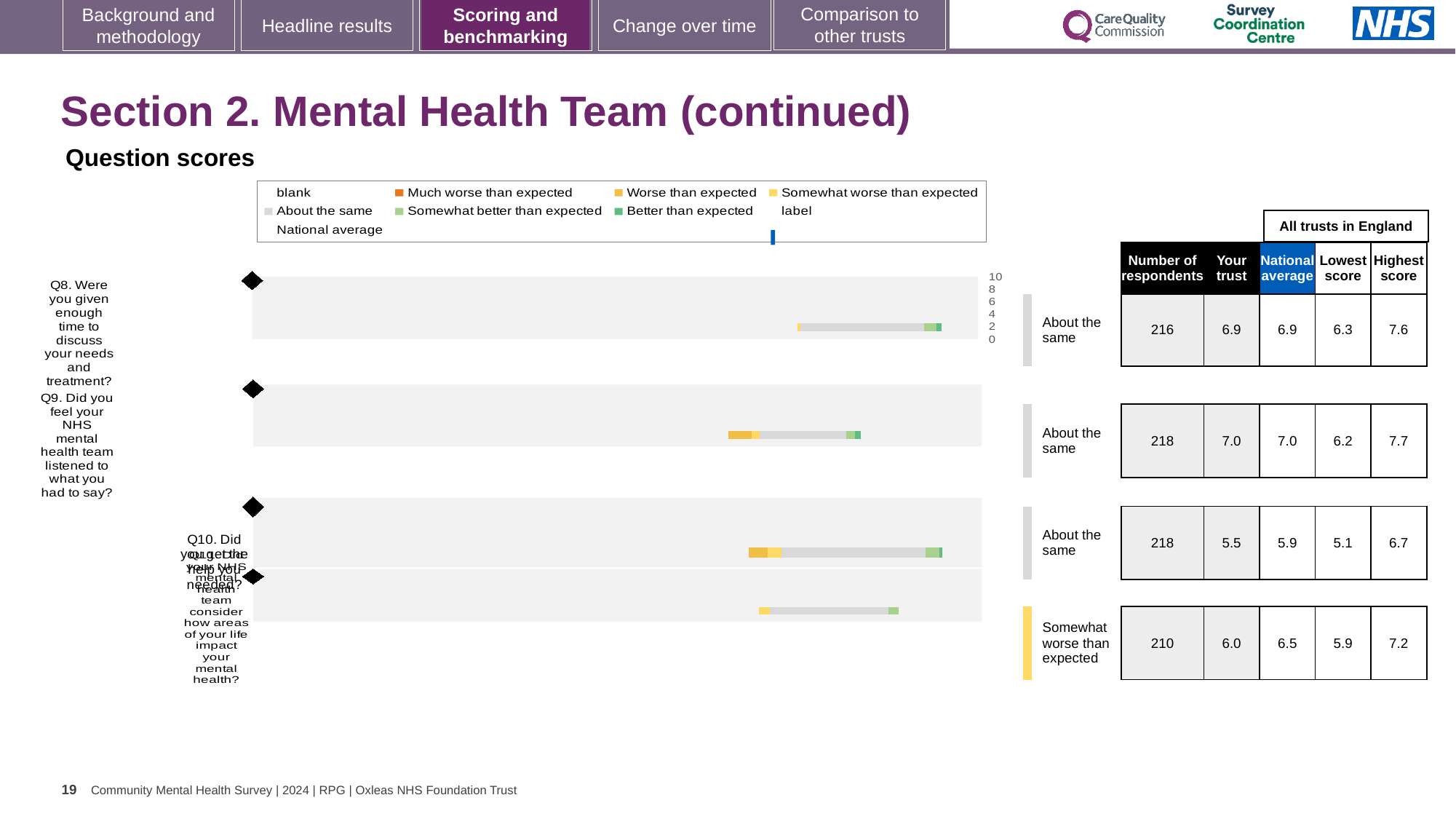
Is the 'Your trust' score for Q9 larger or smaller than the 'Your trust' score for Q10? larger How many question rows are plotted in the chart? 4 In the table beside the chart, what is the highest score for the last question row (Q11)? 7.2 In the table beside the chart, what is the number of respondents for Q9 (Did you feel your NHS mental health team listened to what you had to say)? 218 In the table beside the chart, what is the national average for Q10 (Did you get the help you needed)? 5.9 What kind of chart is shown under 'Question scores'? bar chart Which benchmark category is shown for the last question row (Q11)? Somewhat worse than expected How many entries does the chart legend list? 9 Which question row has the highest 'Your trust' score in the table beside the chart? Q9. Did you feel your NHS mental health team listened to what you had to say? Which question row has the lowest 'Your trust' score in the table beside the chart? Q10. Did you get the help you needed? In the table beside the chart, what is the 'Your trust' score for Q8 (Were you given enough time to discuss your needs and treatment)? 6.9 What is the difference between the national average and the 'Your trust' score for the last question row (Q11)? 0.5